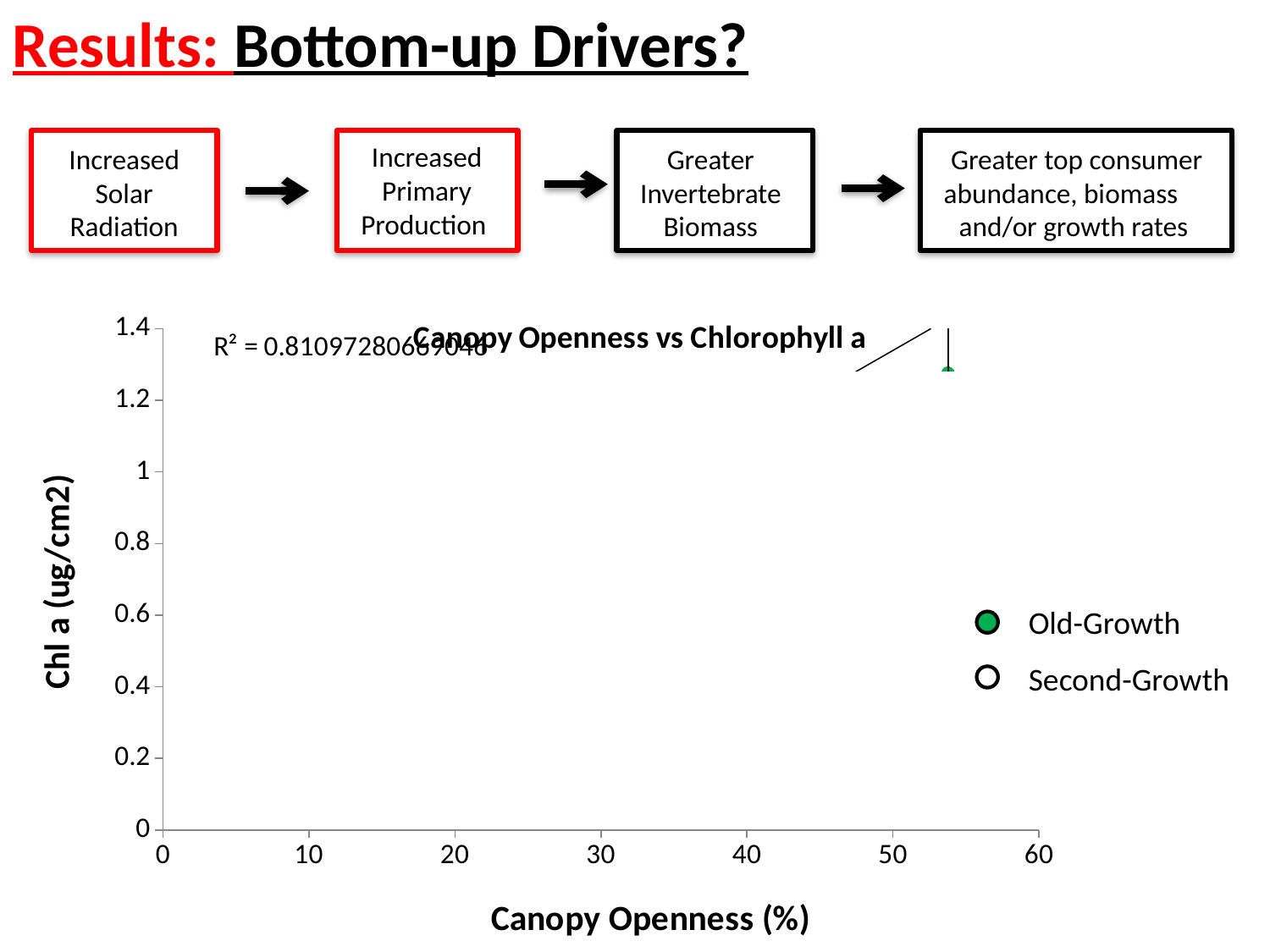
What is the maximum value shown on the x axis of the chart? 60 What is the title of the chart? Canopy Openness vs Chlorophyll a How many series does the chart legend list? 2 Is the canopy openness of the visible Old-Growth point greater or less than 50? greater Is the R² value shown on the chart greater or less than 0.8? greater What are the two series named in the chart legend? Old-Growth and Second-Growth What is the maximum value shown on the y axis of the chart? 1.4 How many data points are visibly plotted on the chart? 1 Is the Chl a value of the visible Old-Growth point greater or less than 1.2? greater What kind of chart is shown on the slide? scatter chart What is the label of the y axis of the chart? Chl a (ug/cm2) What is the label of the x axis of the chart? Canopy Openness (%)